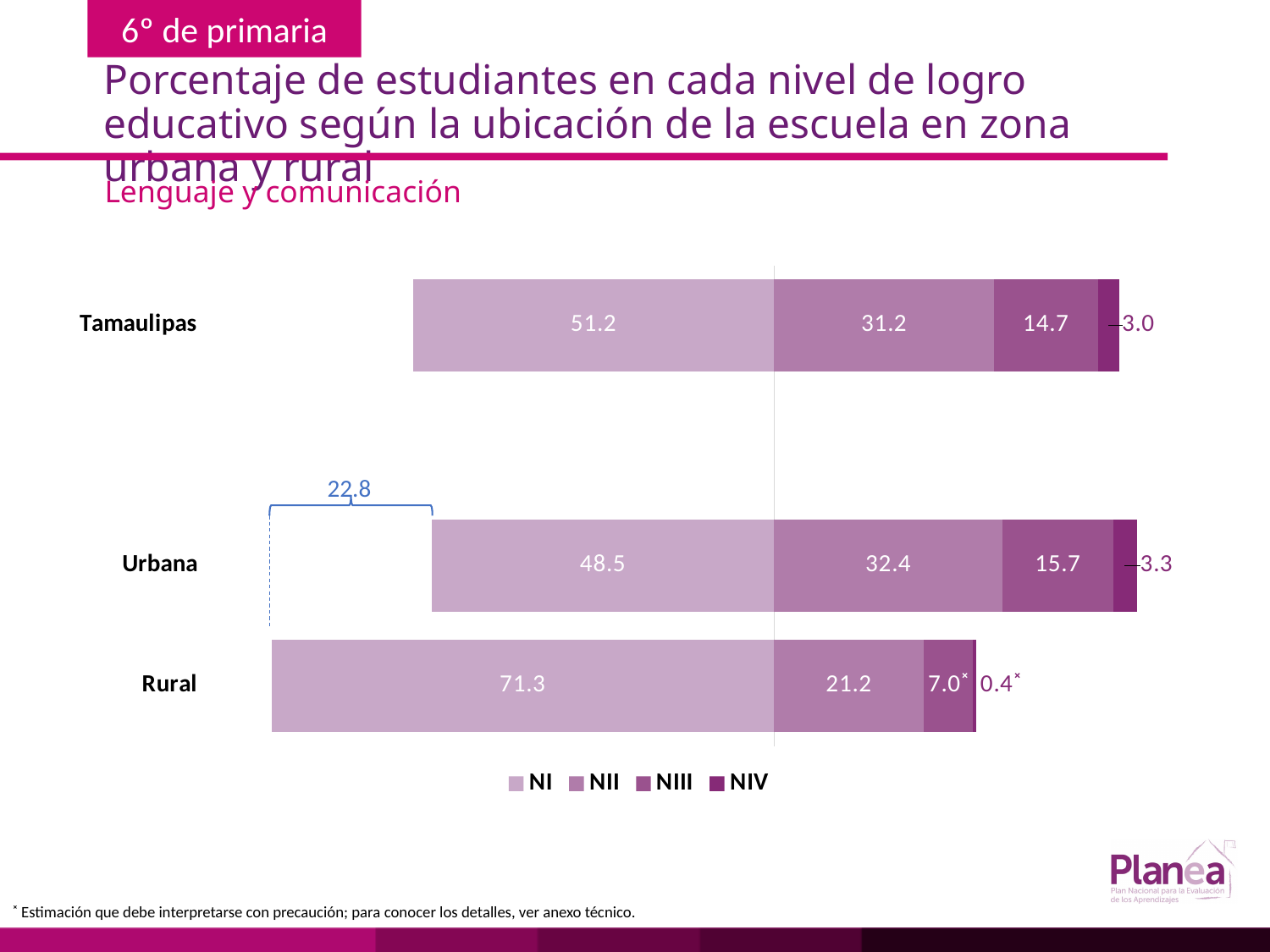
What is the NI value for Tamaulipas? 51.2 What is the subtitle shown below the chart title? Lenguaje y comunicación What type of chart is shown on the slide? Stacked bar chart Which is larger, the NIII value for Tamaulipas or the NIII value for Urbana? Urbana What is the difference between the NI values for Rural and Urbana? 22.8 How many series does the legend list? 4 Which category has the highest NI value? Rural What is the NIV value for Urbana? 3.3 Which category has the lowest NIV value? Rural What is the NIII value for Rural? 7.0 How many categories are plotted on the chart? 3 What is the NII value for Urbana? 32.4